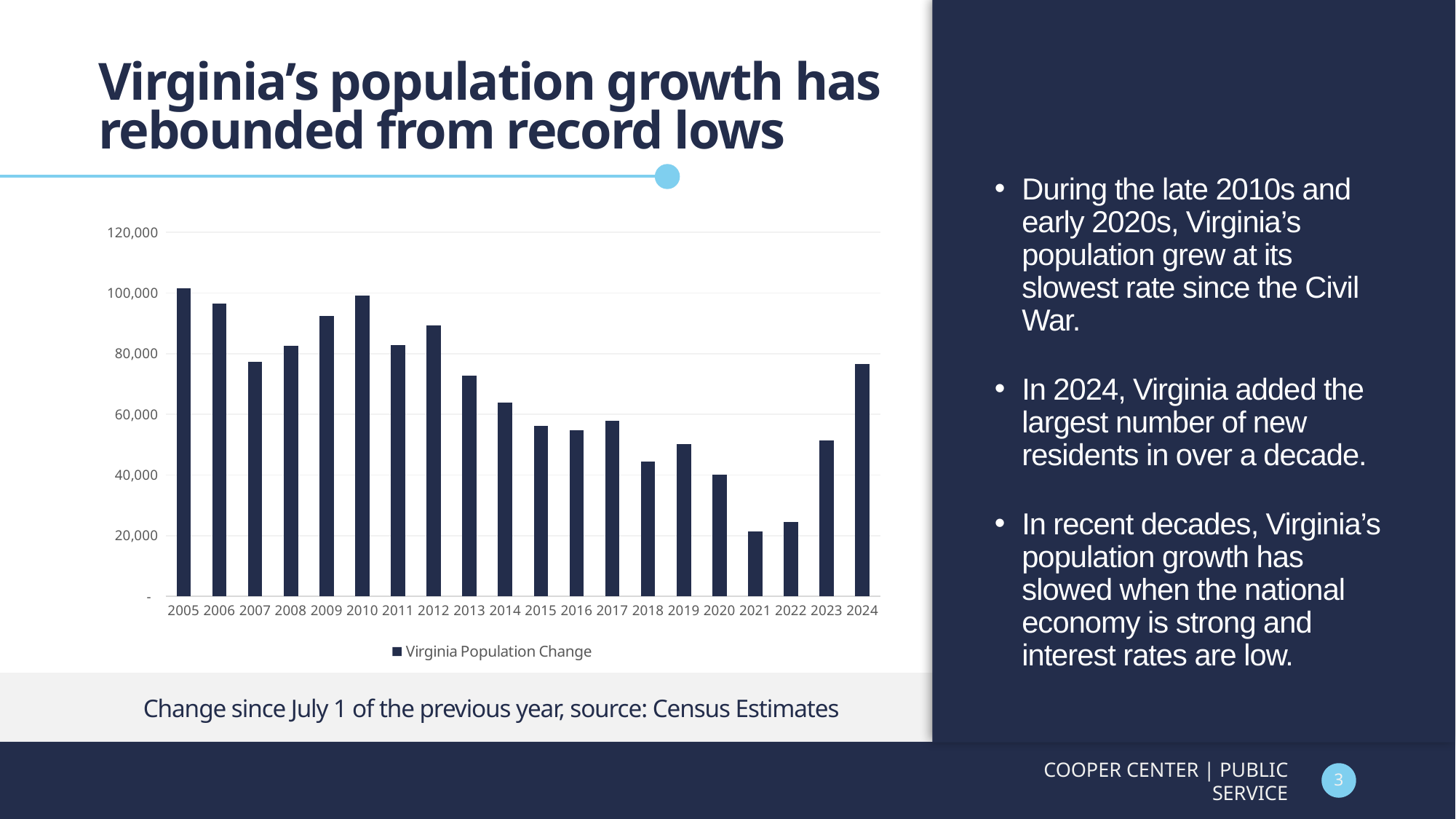
Which year has the larger population change, 2023 or 2024? 2024 Is the value for 2006 greater or less than 80,000? greater Is the value for 2022 greater or less than 40,000? less How many years are plotted on the x axis? 20 Is the value for 2018 greater or less than 60,000? less Which year has the larger population change, 2007 or 2009? 2009 Which year has the lowest Virginia population change? 2021 Do the values rise or fall from 2021 to 2024? rise What kind of chart is shown on the slide? bar chart How many series does the legend list? 1 What is the name of the series shown in the legend? Virginia Population Change